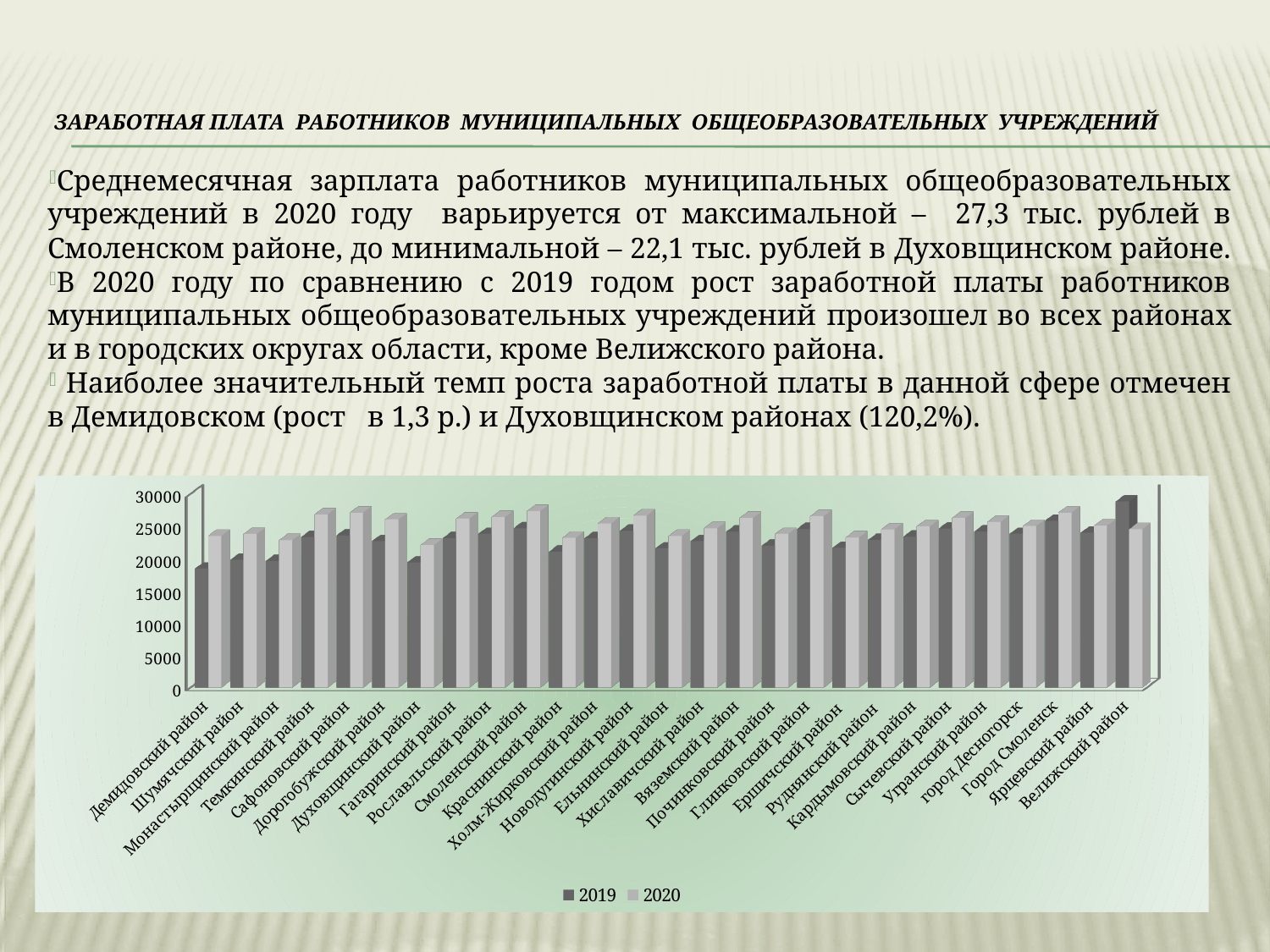
How many districts (categories) are shown on the x axis of the chart? 27 Which series is drawn in the darker grey bars? 2019 Is the 2019 value for Демидовский район greater or less than 25000? less How many series does the legend list? 2 For Демидовский район, which is larger: the 2019 value or the 2020 value? 2020 Is the 2019 value for Велижский район greater or less than 25000? greater For Велижский район, which is larger: the 2019 value or the 2020 value? 2019 Is the 2020 value for Смоленский район greater or less than 25000? greater Which series are listed in the legend? 2019 and 2020 Which district has the lowest value in the 2020 series? Духовщинский район Which district has the highest value in the 2019 series? Велижский район What kind of chart is shown on the slide? bar chart